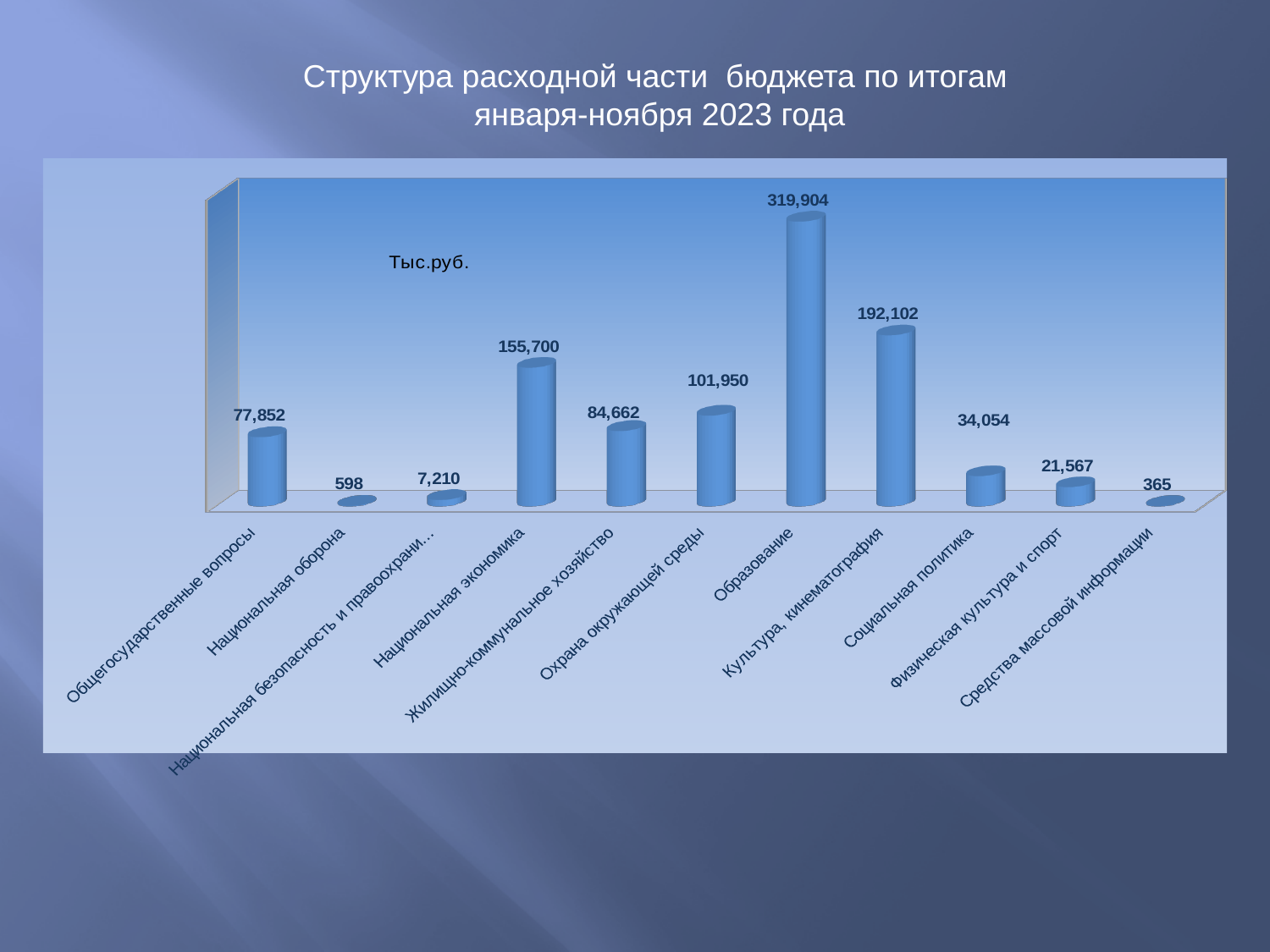
How many categories are shown in the chart? 11 What kind of chart is shown on the slide? Bar chart Which category has the highest value? Образование What is the difference between the values for Национальная экономика and Жилищно-коммунальное хозяйство? 71,038 Which is larger, the value for Охрана окружающей среды or the value for Общегосударственные вопросы? Охрана окружающей среды What is the value for Образование? 319,904 What is the difference between the values for Образование and Культура, кинематография? 127,802 What unit of measurement is indicated on the chart? Тыс.руб. What is the value for Социальная политика? 34,054 What is the value for Национальная экономика? 155,700 Which is larger, the value for Физическая культура и спорт or the value for Национальная оборона? Физическая культура и спорт Which category has the lowest value? Средства массовой информации